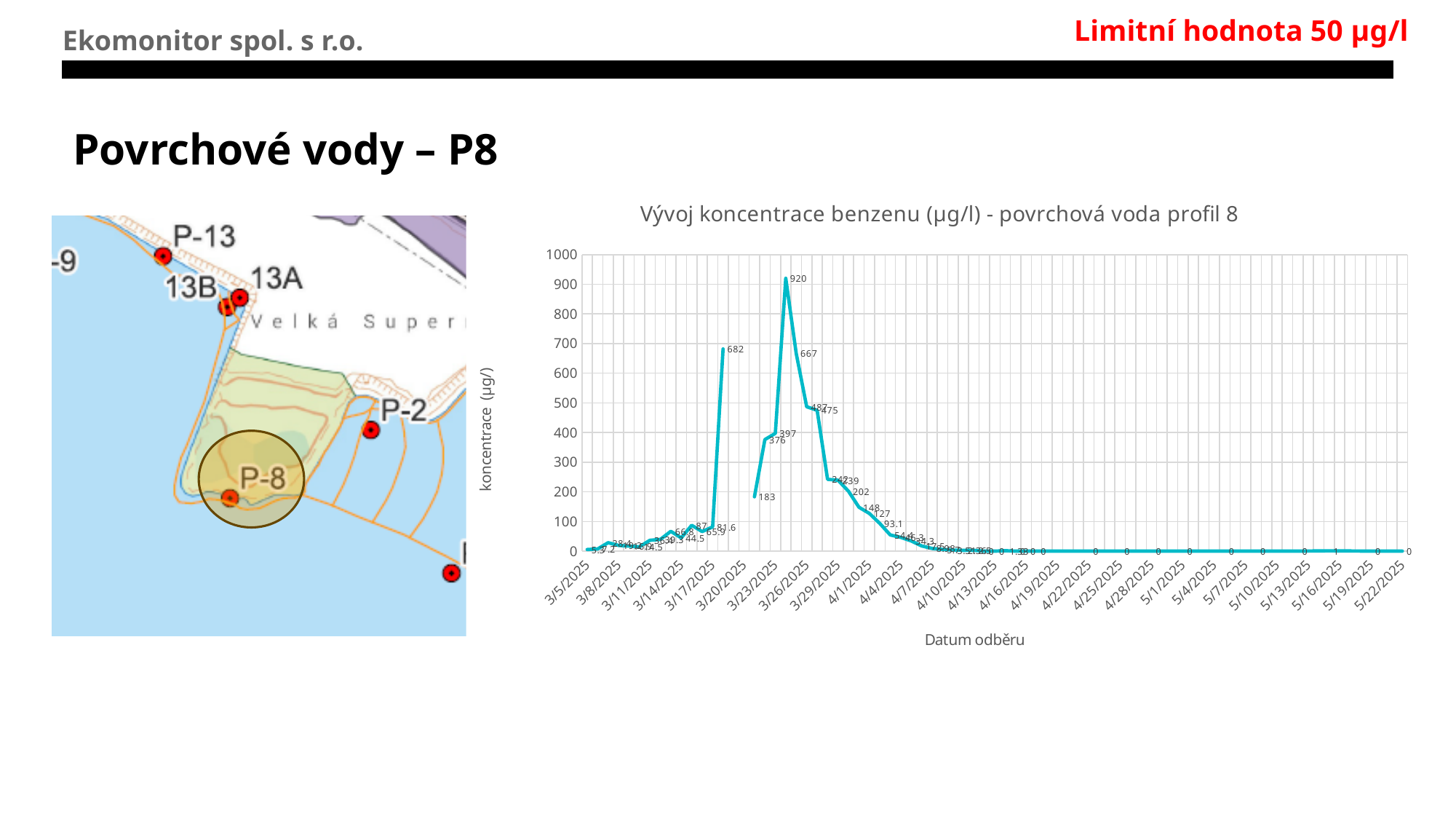
What is the highest value labelled on the chart? 920 Do the values rise or fall along the x axis from the peak in late March to mid-April? fall What is the difference between the labelled values 920 and 667? 253 What type of chart is shown on the slide? line chart What is the maximum value shown on the y axis of the chart? 1000 Which labelled value is larger, 667 or 487? 667 Is the value for 5/22/2025 greater or less than 100? less How many data series are plotted on the chart? 1 What is the title of the chart? Vývoj koncentrace benzenu (µg/l) - povrchová voda profil 8 Is the value for 4/25/2025 greater or less than 100? less What is the difference between the highest labelled value (920) and the labelled value 682? 238 What is the label of the x axis of the chart? Datum odběru